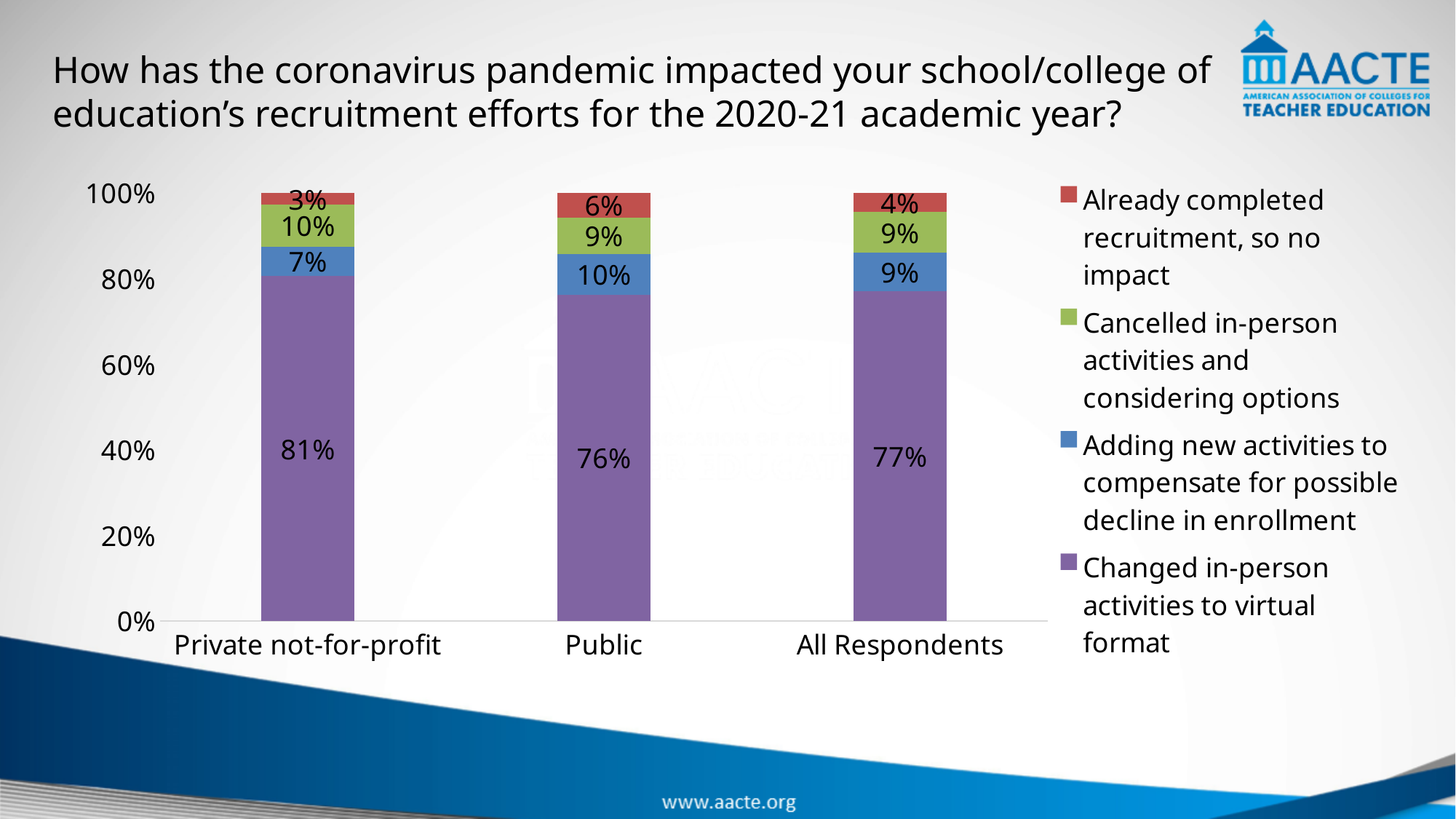
What percentage of Public respondents already completed recruitment, so no impact? 6% How many series does the legend list? 4 Which category has the highest share for 'Changed in-person activities to virtual format'? Private not-for-profit Which legend entry is shown in purple? Changed in-person activities to virtual format Which category has the lowest share for 'Already completed recruitment, so no impact'? Private not-for-profit What is the difference between the 'Changed in-person activities to virtual format' share for Private not-for-profit and Public? 5% Which is larger: the 'Adding new activities' share for Public or for Private not-for-profit? Public What percentage of All Respondents are adding new activities to compensate for possible decline in enrollment? 9% What kind of chart is shown on the slide? Stacked bar chart How many categories are shown on the x axis? 3 What percentage of Private not-for-profit respondents changed in-person activities to virtual format? 81% What percentage of Private not-for-profit respondents cancelled in-person activities and are considering options? 10%